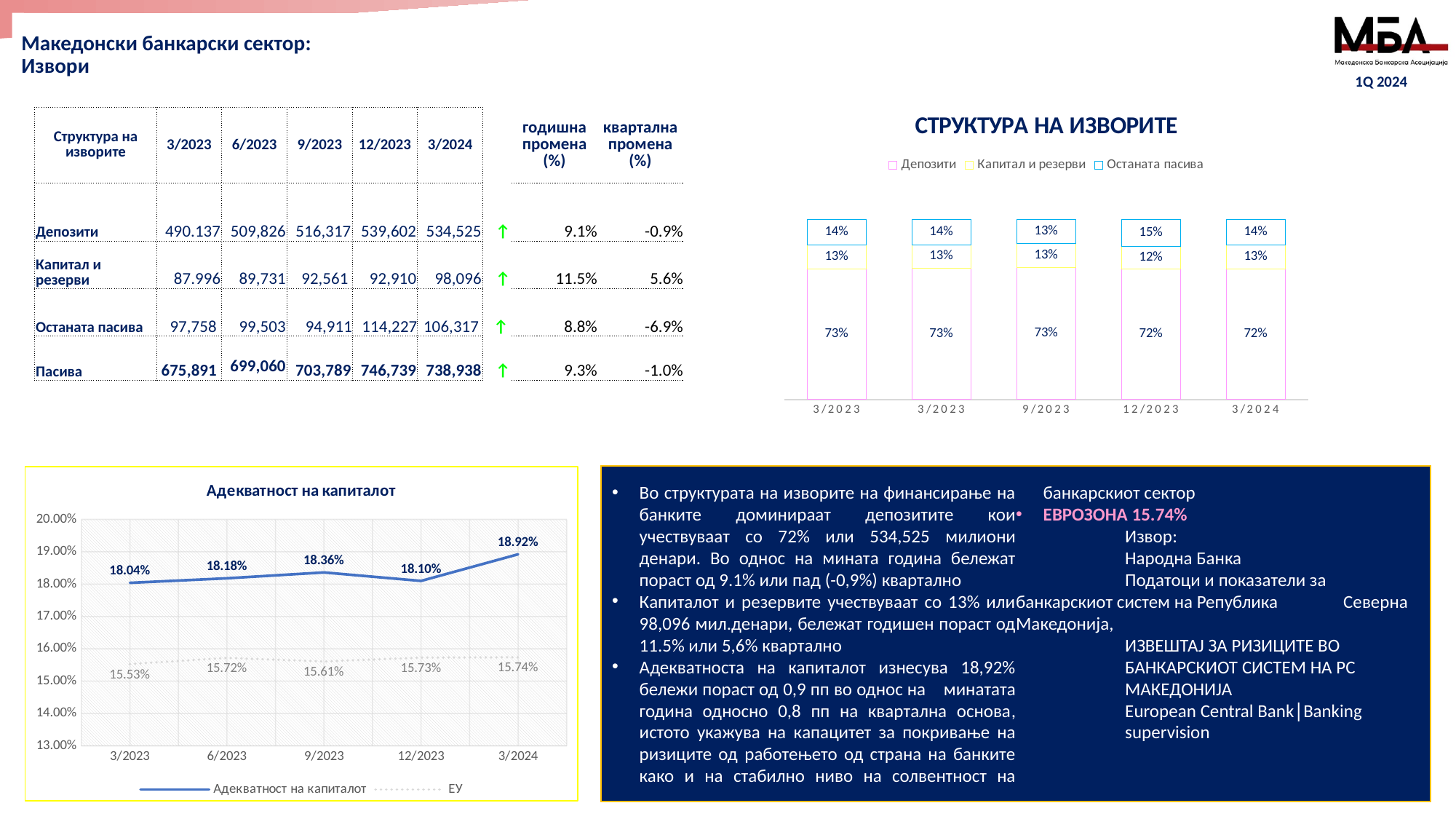
In the "Адекватност на капиталот" chart, what is the value of Адекватност на капиталот in 3/2024? 18.92% In the "Адекватност на капиталот" chart, is the ЕУ value in 3/2024 greater or less than 16.00%? less In the "СТРУКТУРА НА ИЗВОРИТЕ" chart, what is the share of Останата пасива in 12/2023? 15% In the "СТРУКТУРА НА ИЗВОРИТЕ" chart, what is the share of Капитал и резерви in 12/2023? 12% In the "Адекватност на капиталот" chart, what is the ЕУ value in 3/2023? 15.53% In the "СТРУКТУРА НА ИЗВОРИТЕ" chart, what is the share of Депозити in 3/2024? 72% How many series does the legend of the "СТРУКТУРА НА ИЗВОРИТЕ" chart list? 3 In the "Адекватност на капиталот" chart, in which period is Адекватност на капиталот lowest? 3/2023 What kind of chart is the "СТРУКТУРА НА ИЗВОРИТЕ" chart? Stacked bar chart How many stacked bars are shown in the "СТРУКТУРА НА ИЗВОРИТЕ" chart? 5 In the "Адекватност на капиталот" chart, in which period is Адекватност на капиталот highest? 3/2024 In the "Адекватност на капиталот" chart, what is the difference between Адекватност на капиталот and ЕУ in 3/2024? 3.18 percentage points